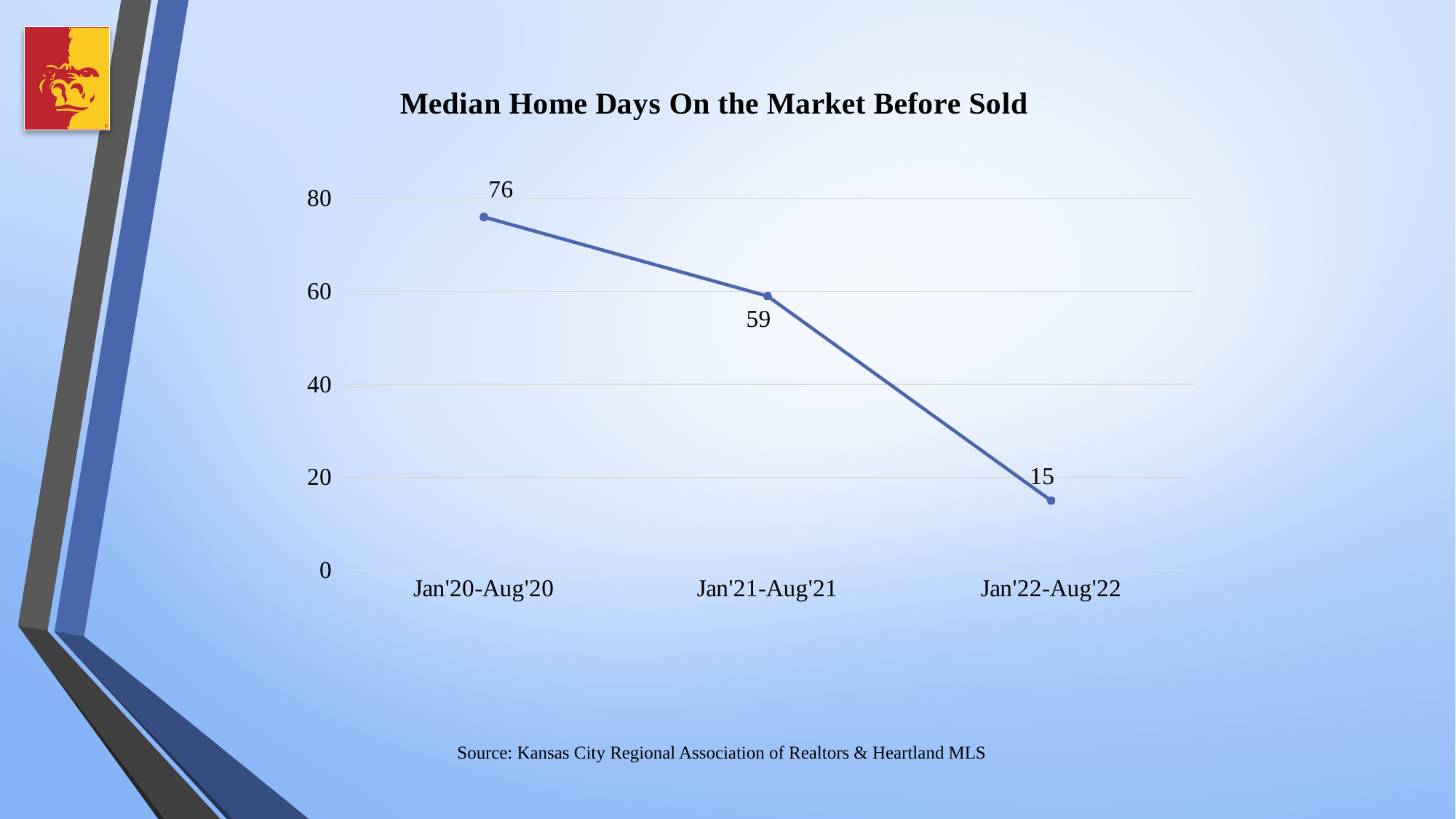
What is the median home days on the market for Jan'22-Aug'22? 15 Which period has the highest median days on the market? Jan'20-Aug'20 Which period has a larger value, Jan'21-Aug'21 or Jan'22-Aug'22? Jan'21-Aug'21 How many periods are plotted on the chart? 3 What is the difference in median days on the market between Jan'20-Aug'20 and Jan'22-Aug'22? 61 What kind of chart is shown on the slide? Line chart Do the values rise or fall from Jan'20-Aug'20 to Jan'22-Aug'22? Fall Which period has the lowest median days on the market? Jan'22-Aug'22 What is the difference in median days on the market between Jan'20-Aug'20 and Jan'21-Aug'21? 17 What is the median home days on the market for Jan'21-Aug'21? 59 Is the value for Jan'21-Aug'21 greater or less than 40? greater What is the median home days on the market for Jan'20-Aug'20? 76